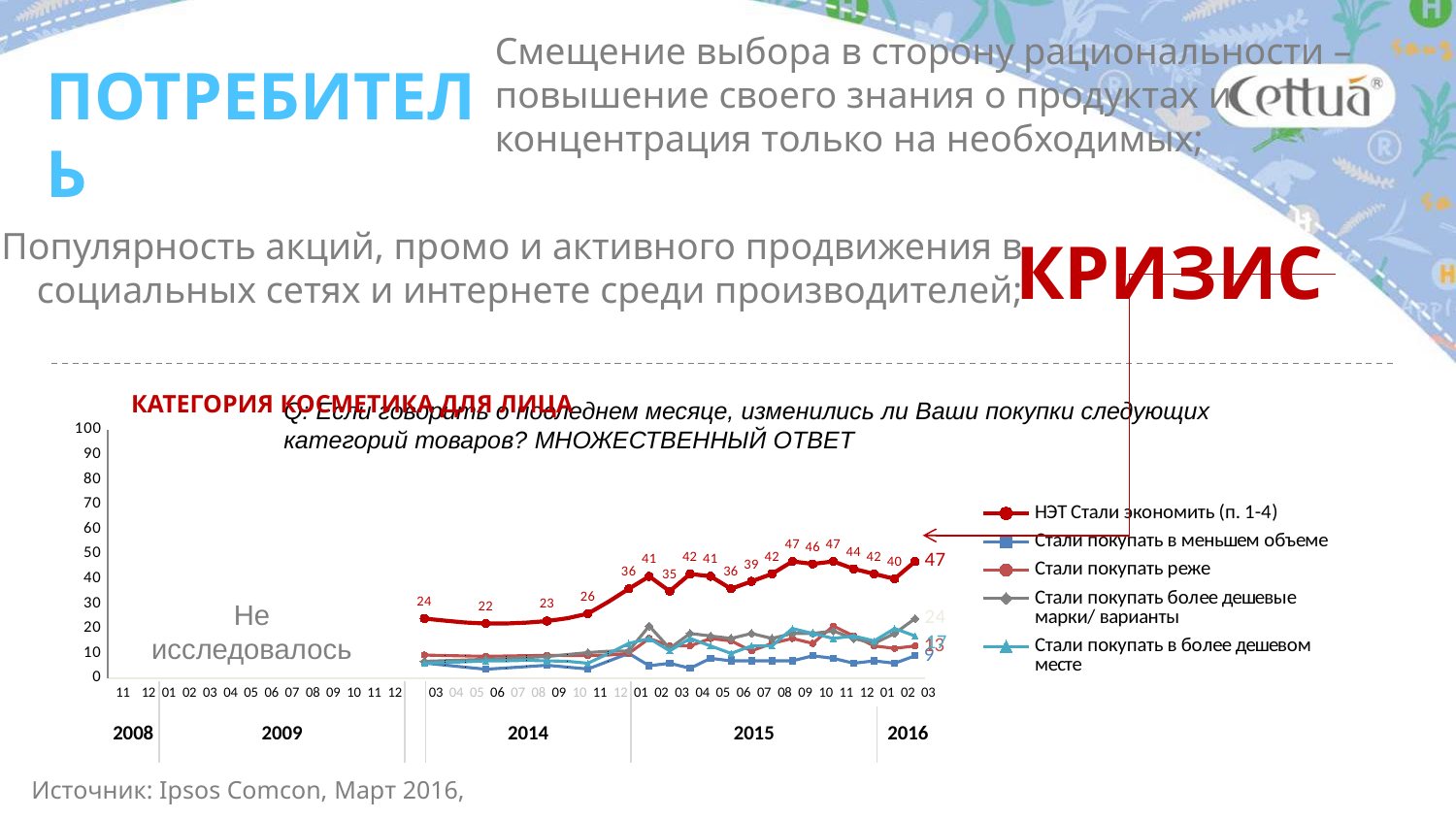
What is the value of the 'НЭТ Стали экономить (п. 1-4)' line in 11 2014? 26 Is the value of 'Стали покупать в меньшем объеме' in 03 2016 greater or less than 20? less Which is larger for 'НЭТ Стали экономить (п. 1-4)': the value in 01 2015 or in 02 2015? 02 2015 How many series does the chart legend list? 5 What is the lowest labelled value on the 'НЭТ Стали экономить (п. 1-4)' line? 22 What kind of chart is shown on the slide? line chart By how much did the 'НЭТ Стали экономить (п. 1-4)' value in 03 2016 exceed the value in 03 2014? 23 What text is shown in the empty left part of the chart covering 2008 and 2009? Не исследовалось Does the 'НЭТ Стали экономить (п. 1-4)' line overall rise or fall from 03 2014 to 03 2016? rise What is the value of the 'НЭТ Стали экономить (п. 1-4)' line in 03 2016? 47 What is the value of the 'НЭТ Стали экономить (п. 1-4)' line in 03 2014? 24 What is the highest labelled value on the 'НЭТ Стали экономить (п. 1-4)' line? 47